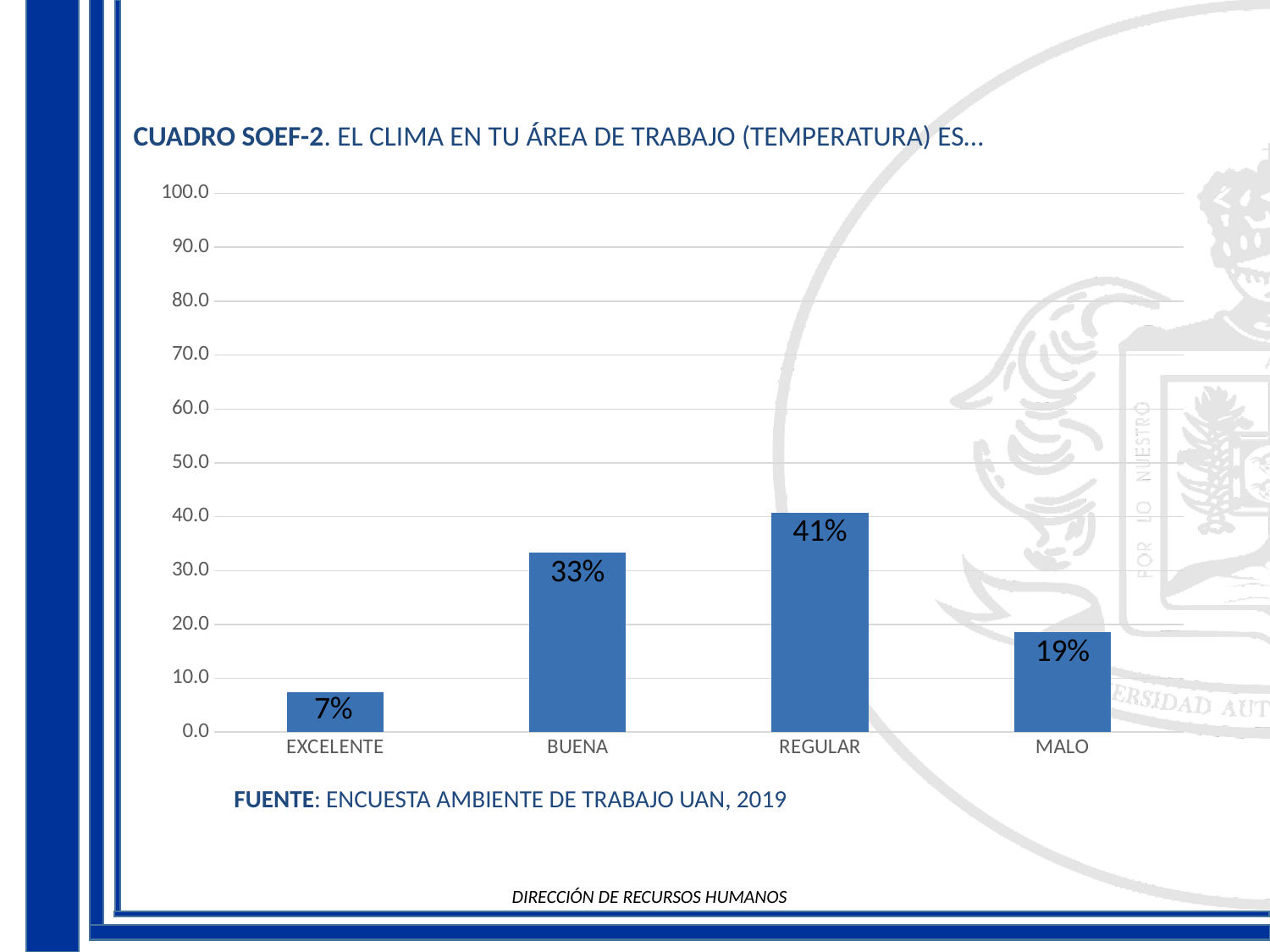
Which is larger, the value for BUENA or the value for MALO? BUENA What source is cited below the chart? ENCUESTA AMBIENTE DE TRABAJO UAN, 2019 Which category has the lowest value? EXCELENTE Which category has the highest value? REGULAR Is the value for BUENA greater or less than 30.0? greater What is the difference between the values for REGULAR and BUENA? 8% How many categories are shown on the x axis? 4 What kind of chart is shown on the slide? bar chart What is the value for MALO? 19% What is the value for EXCELENTE? 7% What is the value for REGULAR? 41% What is the maximum value shown on the y axis? 100.0